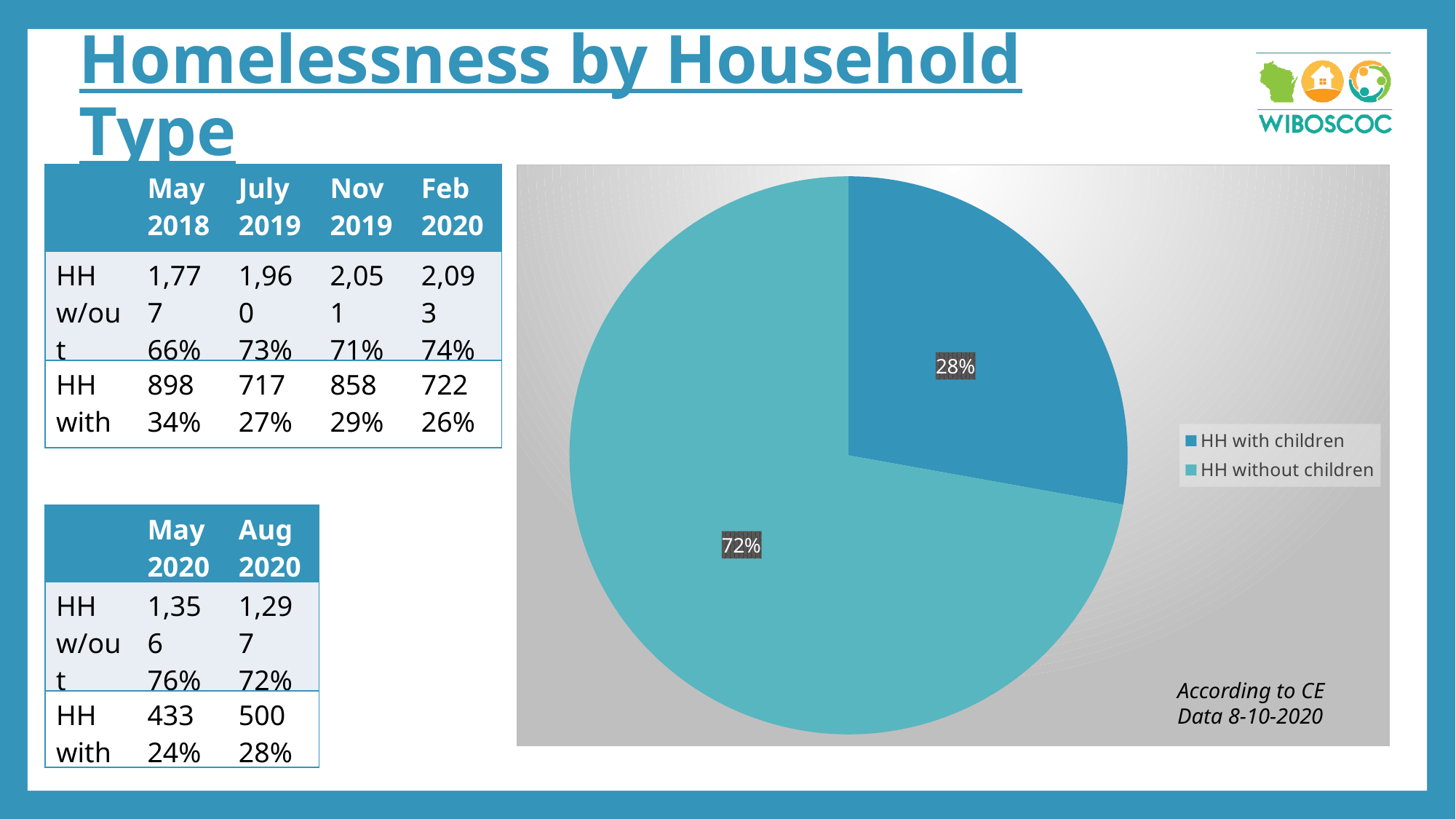
What share of the pie chart is labelled for HH without children? 72% How many slices does the pie chart have? 2 In the pie chart, which is larger: HH with children or HH without children? HH without children Which slice of the pie chart is the largest? HH without children Is the share for HH with children in the pie chart greater or less than 50%? less What share of the pie chart is labelled for HH with children? 28% How many entries does the pie chart's legend list? 2 What kind of chart is shown on the slide? pie chart What are the two legend entries of the pie chart? HH with children, HH without children Which slice of the pie chart is the smallest? HH with children According to the note on the pie chart, what is the data source and date? According to CE Data 8-10-2020 What is the difference in percentage points between the HH without children slice and the HH with children slice in the pie chart? 44